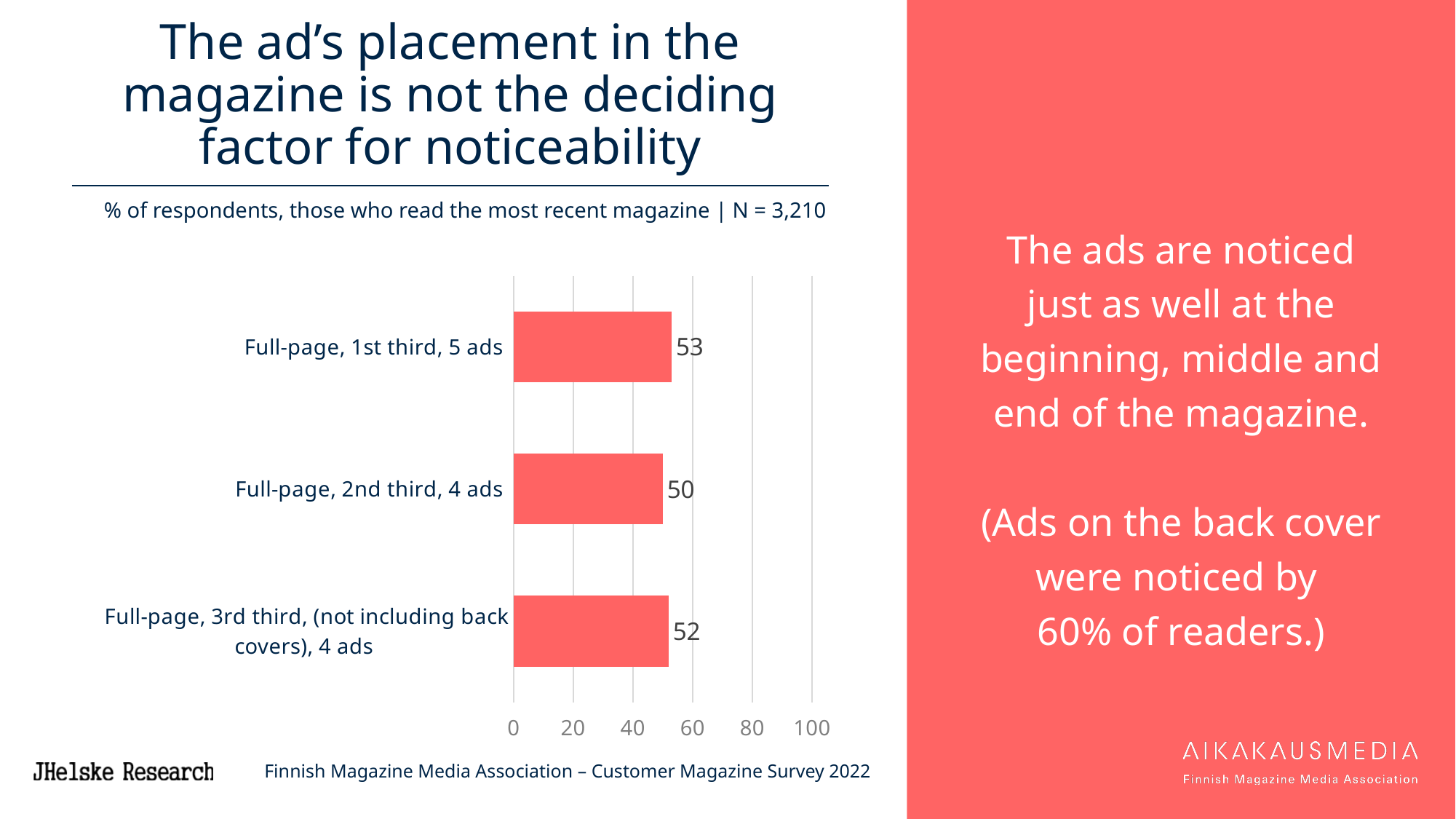
What is the maximum value shown on the chart's axis? 100 What is the value for "Full-page, 1st third, 5 ads"? 53 How many categories are shown in the chart? 3 What is the difference between the values for "Full-page, 1st third, 5 ads" and "Full-page, 2nd third, 4 ads"? 3 What is the value for "Full-page, 2nd third, 4 ads"? 50 What kind of chart is shown on the slide? bar chart Is the value for "Full-page, 1st third, 5 ads" greater or less than 40? greater Which category has the highest value? Full-page, 1st third, 5 ads Which category has the lowest value? Full-page, 2nd third, 4 ads Is the value for "Full-page, 2nd third, 4 ads" greater or less than 60? less What is the difference between the values for "Full-page, 3rd third, (not including back covers), 4 ads" and "Full-page, 2nd third, 4 ads"? 2 What is the value for "Full-page, 3rd third, (not including back covers), 4 ads"? 52